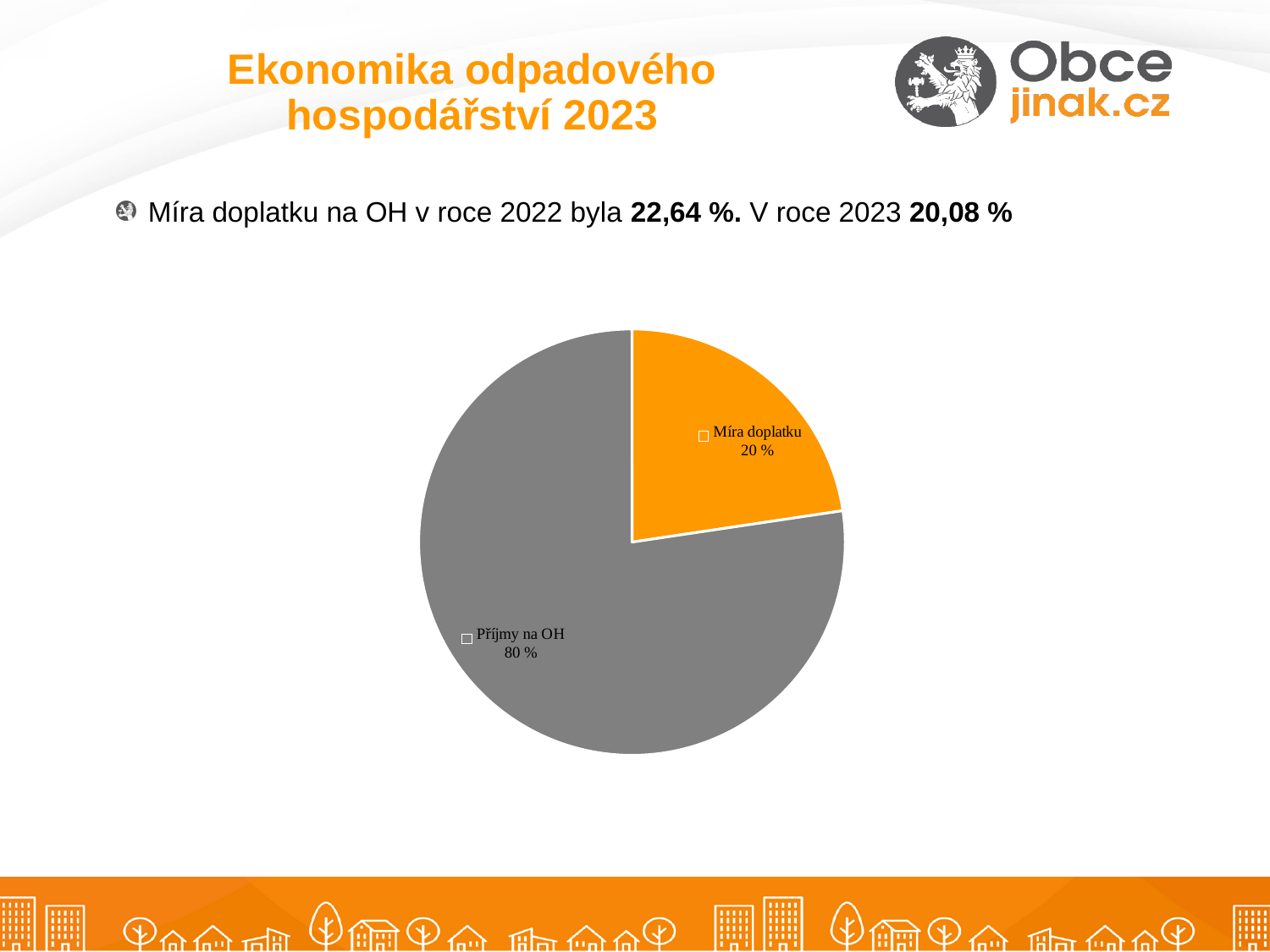
Which is larger, the share for "Příjmy na OH" or the share for "Míra doplatku"? Příjmy na OH What kind of chart is shown on the slide? pie chart Which slice of the pie is the smallest? Míra doplatku What share of the pie does "Příjmy na OH" represent? 80 % What colour is the "Míra doplatku" slice? orange What colour is the "Příjmy na OH" slice? grey What share of the pie does "Míra doplatku" represent? 20 % What is the difference in percentage points between the "Příjmy na OH" share and the "Míra doplatku" share? 60 % Which slice of the pie is the largest? Příjmy na OH How many slices does the pie chart have? 2